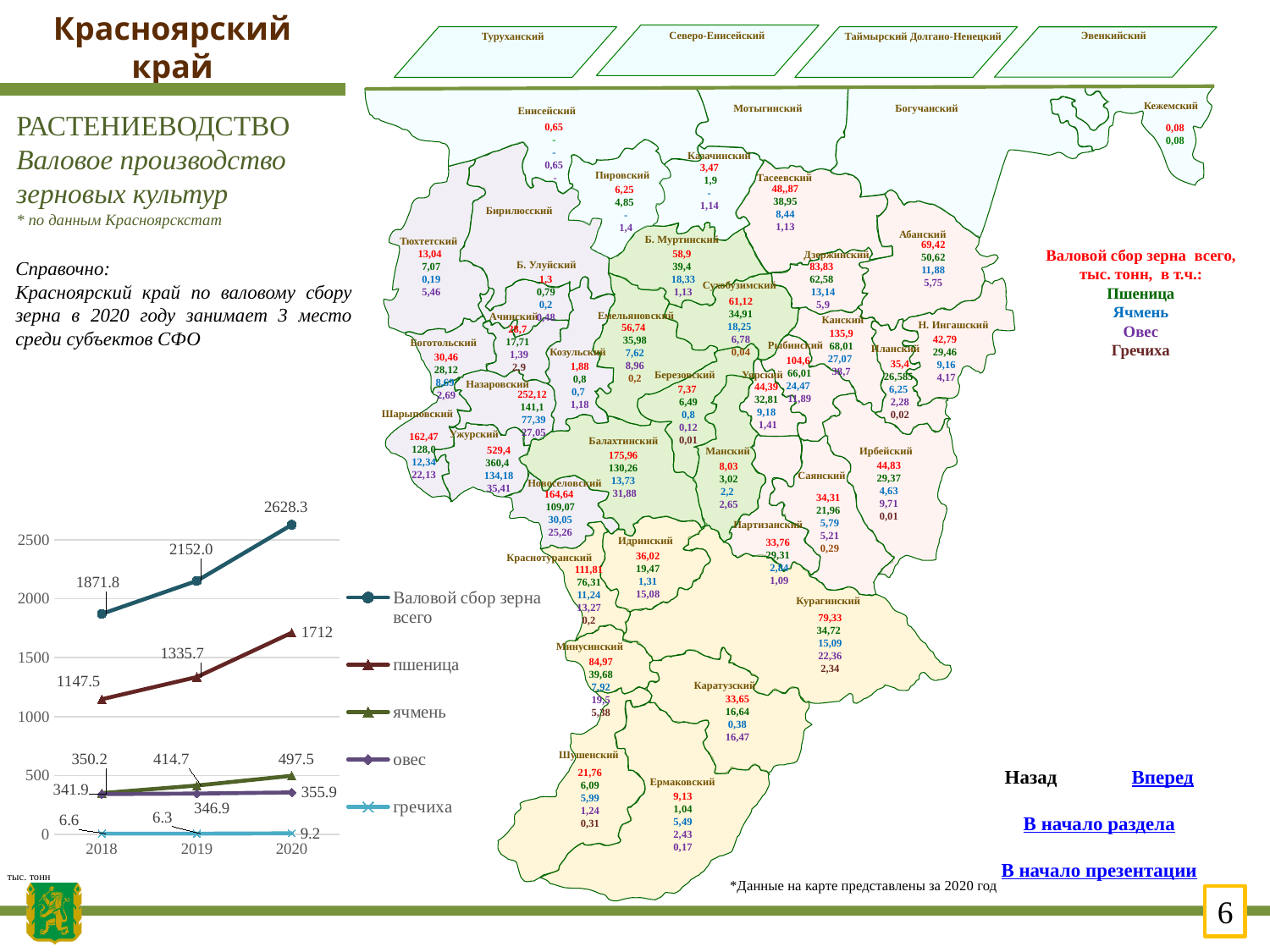
In the line chart, which year has the highest value for 'ячмень'? 2020 In the line chart, what is the value of 'Валовой сбор зерна всего' in 2020? 2628.3 In the line chart, what is the value of 'гречиха' in 2018? 6.6 In the line chart, what is the difference between 'Валовой сбор зерна всего' in 2020 and in 2018? 756.5 In the line chart, what is the value of 'пшеница' in 2019? 1335.7 In the line chart, which year has the lowest value for 'гречиха'? 2019 In the line chart, does the value of 'пшеница' rise or fall from 2018 to 2020? rise How many years are plotted on the x axis of the line chart? 3 How many series does the legend of the line chart list? 5 What type of chart is shown in the bottom-left of the slide? line chart In the line chart, which is larger in 2019: 'ячмень' or 'овес'? ячмень In the line chart, what is the value of 'овес' in 2020? 355.9